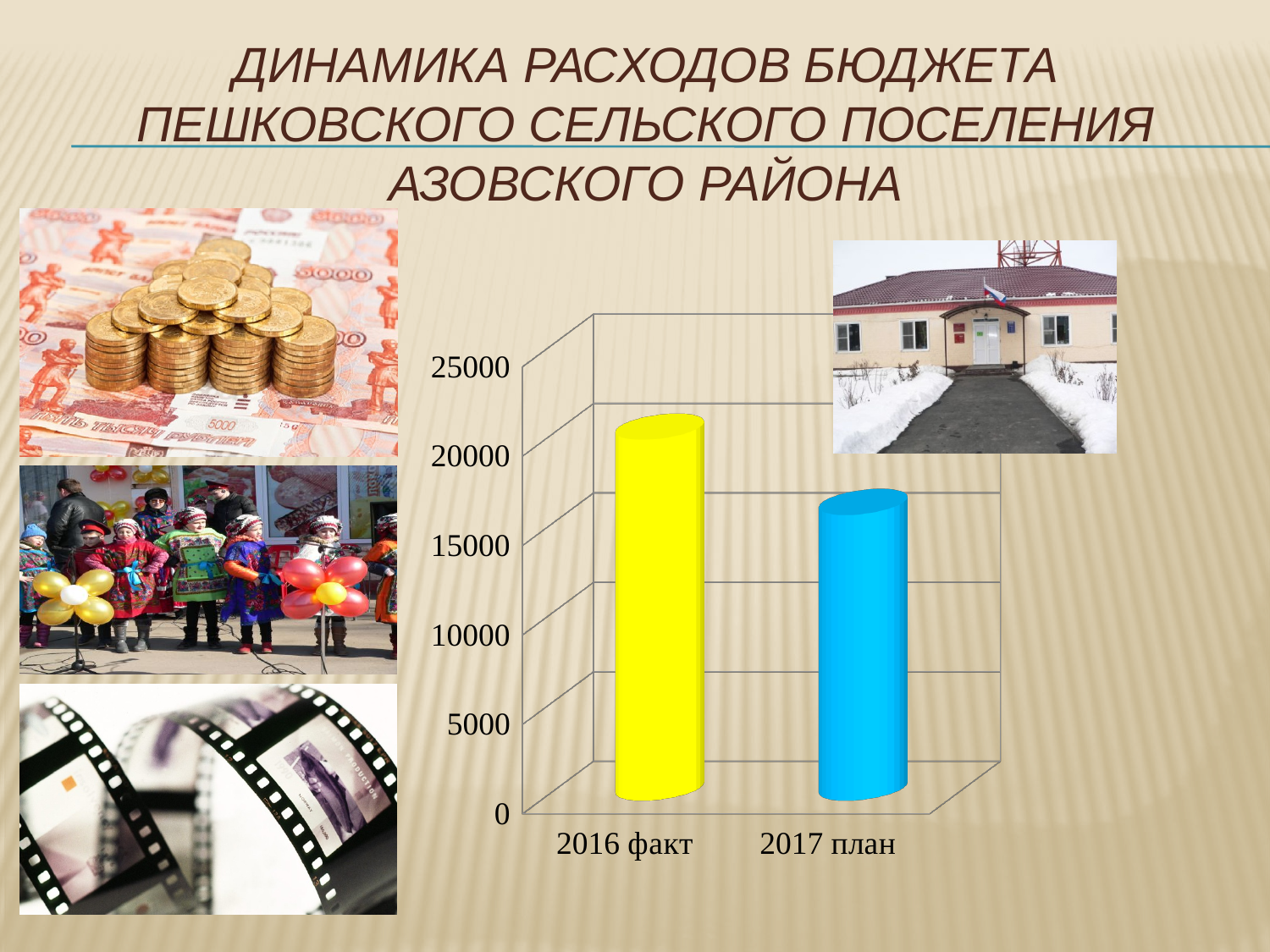
Is the value for 2016 факт greater or less than 25000? less What kind of chart is shown on the slide? bar chart What colour is the bar for 2017 план? blue How many categories are plotted on the x axis of the chart? 2 What is the highest tick value shown on the vertical axis of the chart? 25000 Which category has the highest value in the chart? 2016 факт Is the value for 2017 план greater or less than 15000? greater Do the values rise or fall from 2016 факт to 2017 план? fall Which category has the lowest value in the chart? 2017 план Which is larger, the value for 2016 факт or the value for 2017 план? 2016 факт Is the value for 2017 план greater or less than 20000? less